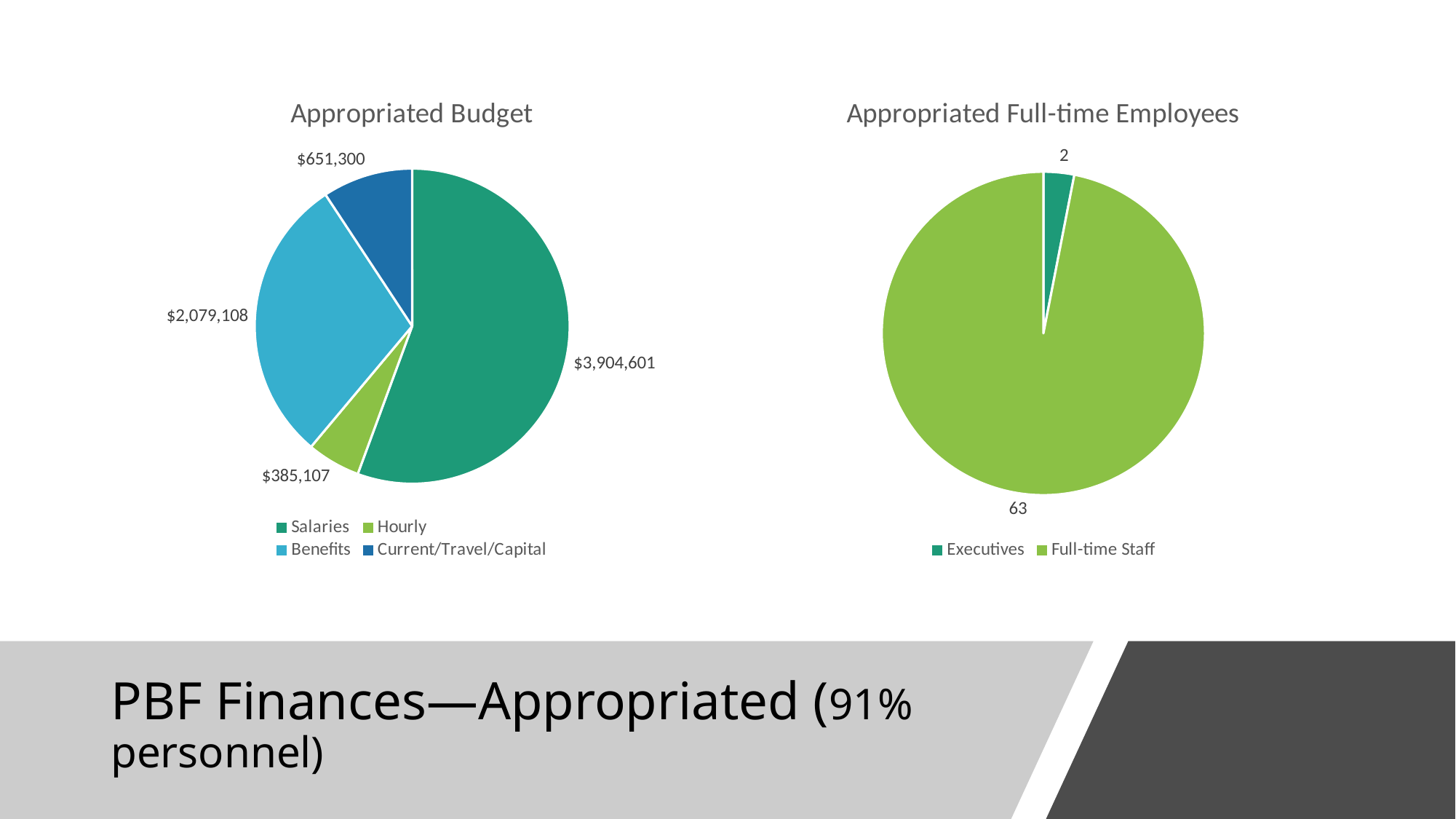
In the "Appropriated Budget" chart, which category has the smallest slice? Hourly In the "Appropriated Full-time Employees" chart, what is the difference between Full-time Staff and Executives? 61 In the "Appropriated Budget" chart, what is the value for Benefits? $2,079,108 How many entries does the legend of the "Appropriated Full-time Employees" chart list? 2 In the "Appropriated Budget" chart, which is larger, Current/Travel/Capital or Hourly? Current/Travel/Capital In the "Appropriated Budget" chart, what is the difference between Salaries and Benefits? $1,825,493 In the "Appropriated Full-time Employees" chart, what is the value for Executives? 2 How many categories does the "Appropriated Budget" chart show? 4 In the "Appropriated Budget" chart, what is the value for Salaries? $3,904,601 In the "Appropriated Budget" chart, which category has the largest slice? Salaries In the "Appropriated Budget" chart, what is the value for Current/Travel/Capital? $651,300 What kind of chart is the "Appropriated Budget" chart? Pie chart